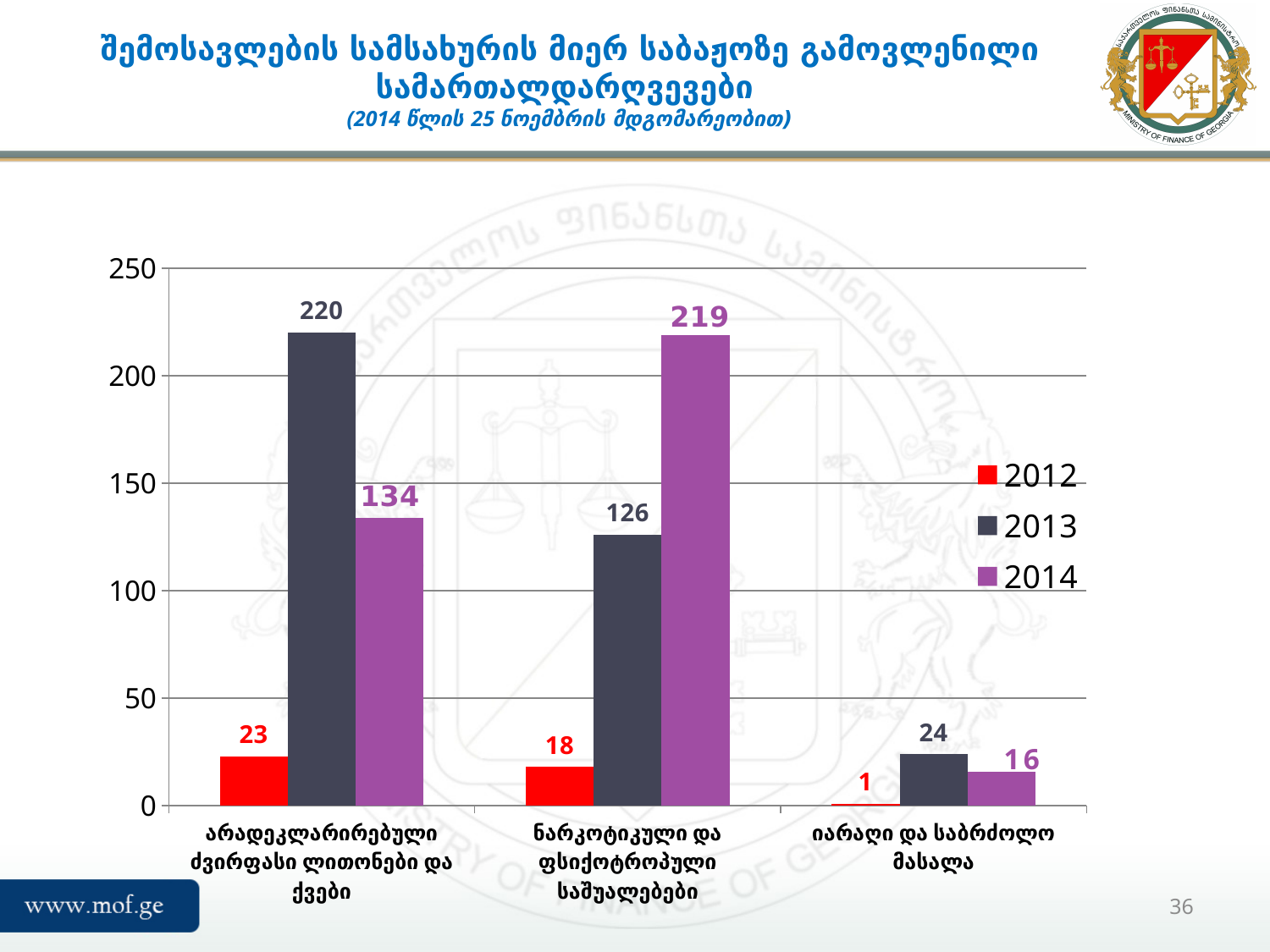
For "ნარკოტიკული და ფსიქოტროპული საშუალებები", which is larger: the 2013 value or the 2014 value? 2014 Which colour represents the 2012 series in the legend? red What is the difference between the 2013 and 2014 values for "არადეკლარირებული ძვირფასი ლითონები და ქვები"? 86 How many series does the legend list? 3 What is the 2012 value for the category "იარაღი და საბრძოლო მასალა"? 1 What is the 2014 value for the category "ნარკოტიკული და ფსიქოტროპული საშუალებები"? 219 Is the 2014 value for "არადეკლარირებული ძვირფასი ლითონები და ქვები" greater or less than 150? less What kind of chart is shown on the slide? bar chart What is the 2013 value for the category "არადეკლარირებული ძვირფასი ლითონები და ქვები"? 220 How many categories are shown on the x axis? 3 Which category has the lowest 2013 value? იარაღი და საბრძოლო მასალა Which category has the highest 2014 value? ნარკოტიკული და ფსიქოტროპული საშუალებები